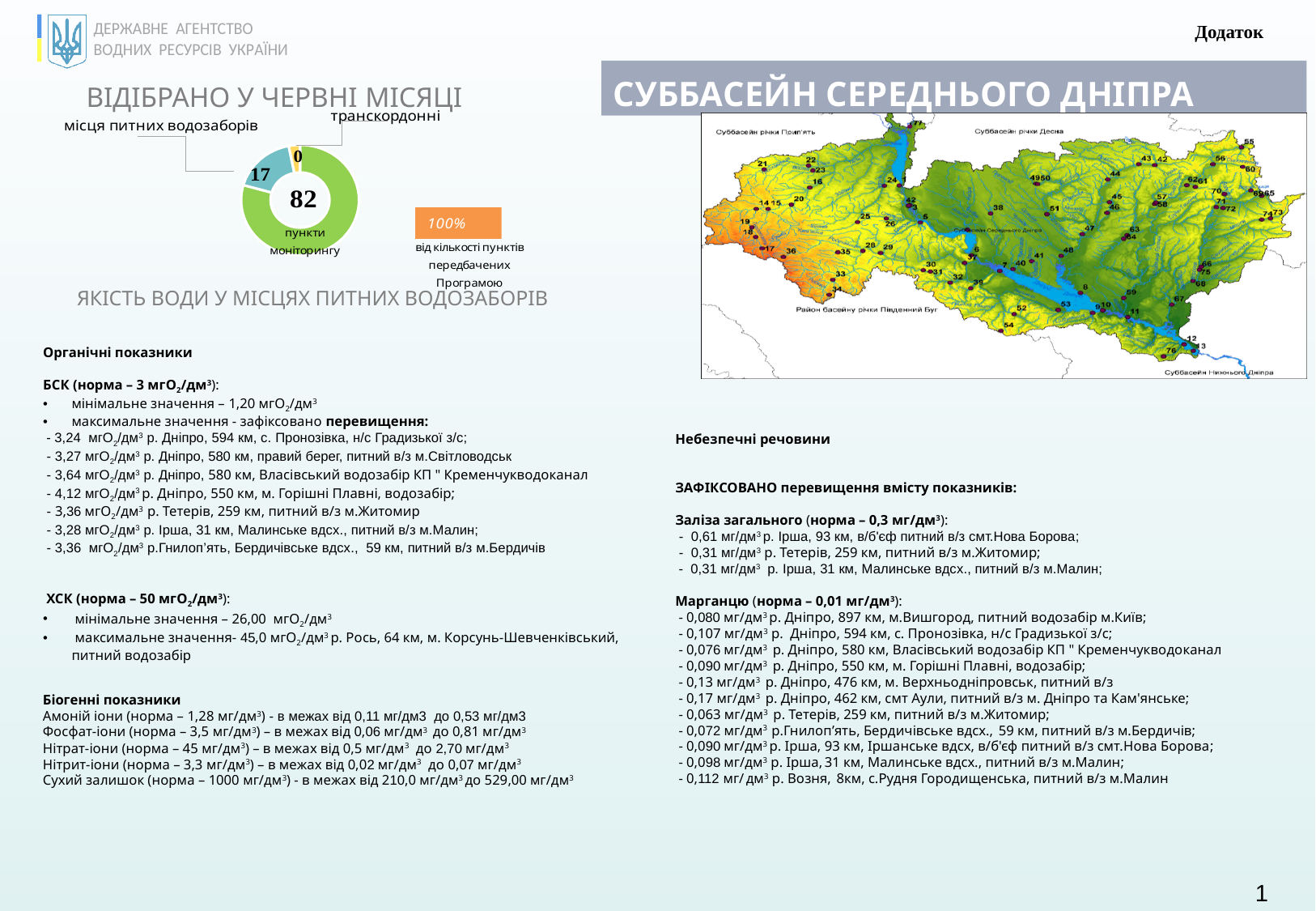
In the doughnut chart, what value is shown for "пункти моніторингу"? 82 Which category in the doughnut chart has the lowest value? транскордонні In the doughnut chart, which is larger: "місця питних водозаборів" or "транскордонні"? місця питних водозаборів In the doughnut chart, what value is shown for "місця питних водозаборів"? 17 How many categories are shown in the doughnut chart? 3 What kind of chart is shown under the title "ВІДІБРАНО У ЧЕРВНІ МІСЯЦІ"? Doughnut (pie) chart In the doughnut chart, what is the difference between the values for "пункти моніторингу" and "місця питних водозаборів"? 65 Which category in the doughnut chart has the highest value? пункти моніторингу What is the title above the doughnut chart? ВІДІБРАНО У ЧЕРВНІ МІСЯЦІ What colour is the largest segment (82) of the doughnut chart? Green In the doughnut chart, what value is shown for "транскордонні"? 0